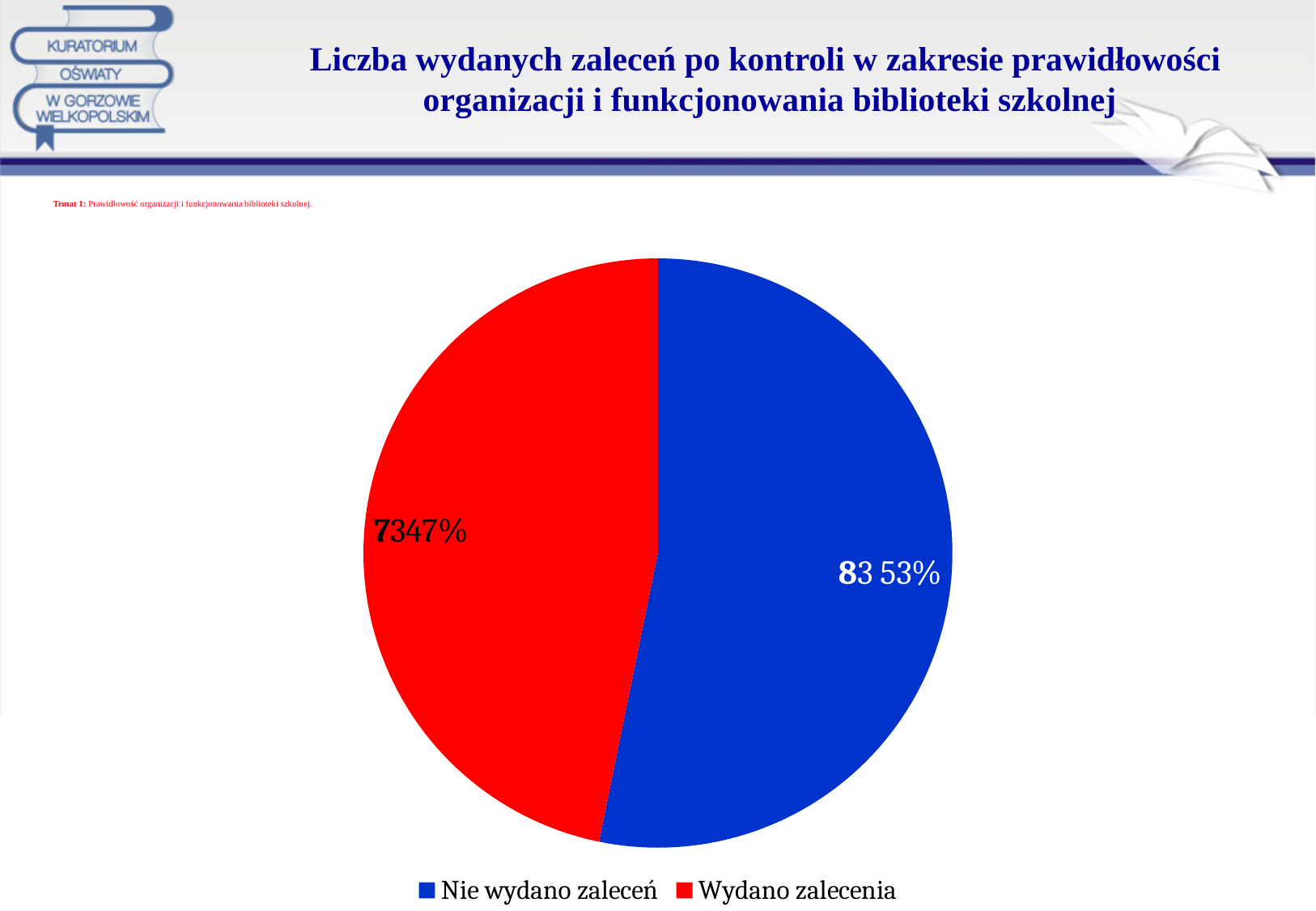
What is the difference between the number for 'Nie wydano zaleceń' and the number for 'Wydano zalecenia'? 10 Which category has the smallest slice of the pie? Wydano zalecenia What colour is the 'Wydano zalecenia' slice? red How many entries does the legend list? 2 Which category has the largest slice of the pie? Nie wydano zaleceń Which is larger, the value for 'Nie wydano zaleceń' or for 'Wydano zalecenia'? Nie wydano zaleceń How many slices does the pie chart have? 2 What percentage share does the 'Nie wydano zaleceń' slice have? 53% What percentage share does the 'Wydano zalecenia' slice have? 47% What kind of chart is shown on the slide? pie chart What is the number shown for 'Nie wydano zaleceń'? 83 What is the number shown for 'Wydano zalecenia'? 73